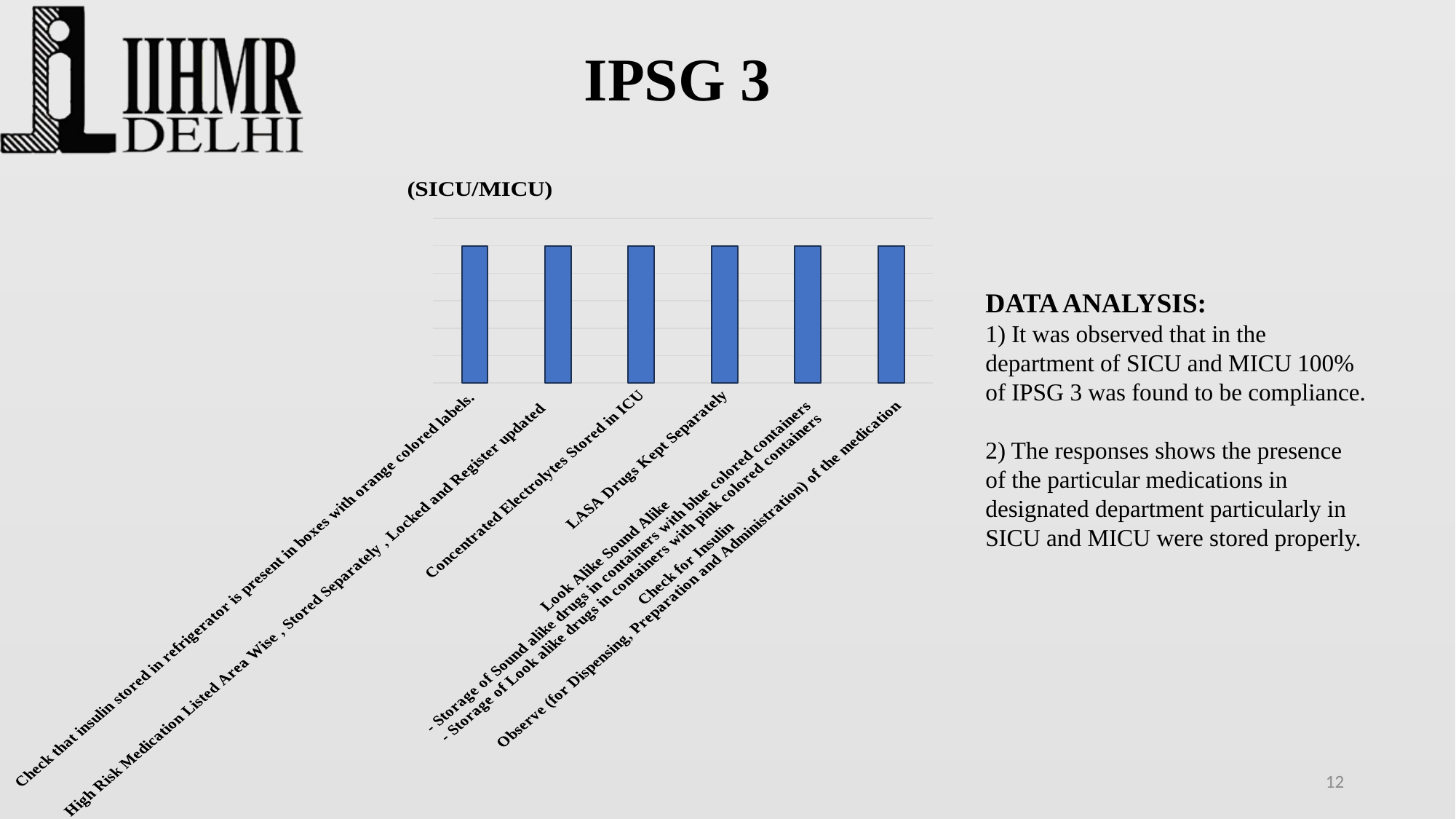
Which category is plotted on the leftmost bar of the chart? Check that insulin stored in refrigerator is present in boxes with orange colored labels. How many bars (categories) does the chart show? 6 Is the bar for "LASA Drugs Kept Separately" taller, shorter, or the same height as the bar for "Check for Insulin"? the same height Do the bar values rise, fall, or stay flat across the categories from left to right? stay flat What is the title of the chart? (SICU/MICU) What colour are the bars in the chart? blue Is the bar for "Concentrated Electrolytes Stored in ICU" taller, shorter, or the same height as the bar for "Look Alike Sound Alike"? the same height What kind of chart is shown on the slide? bar chart